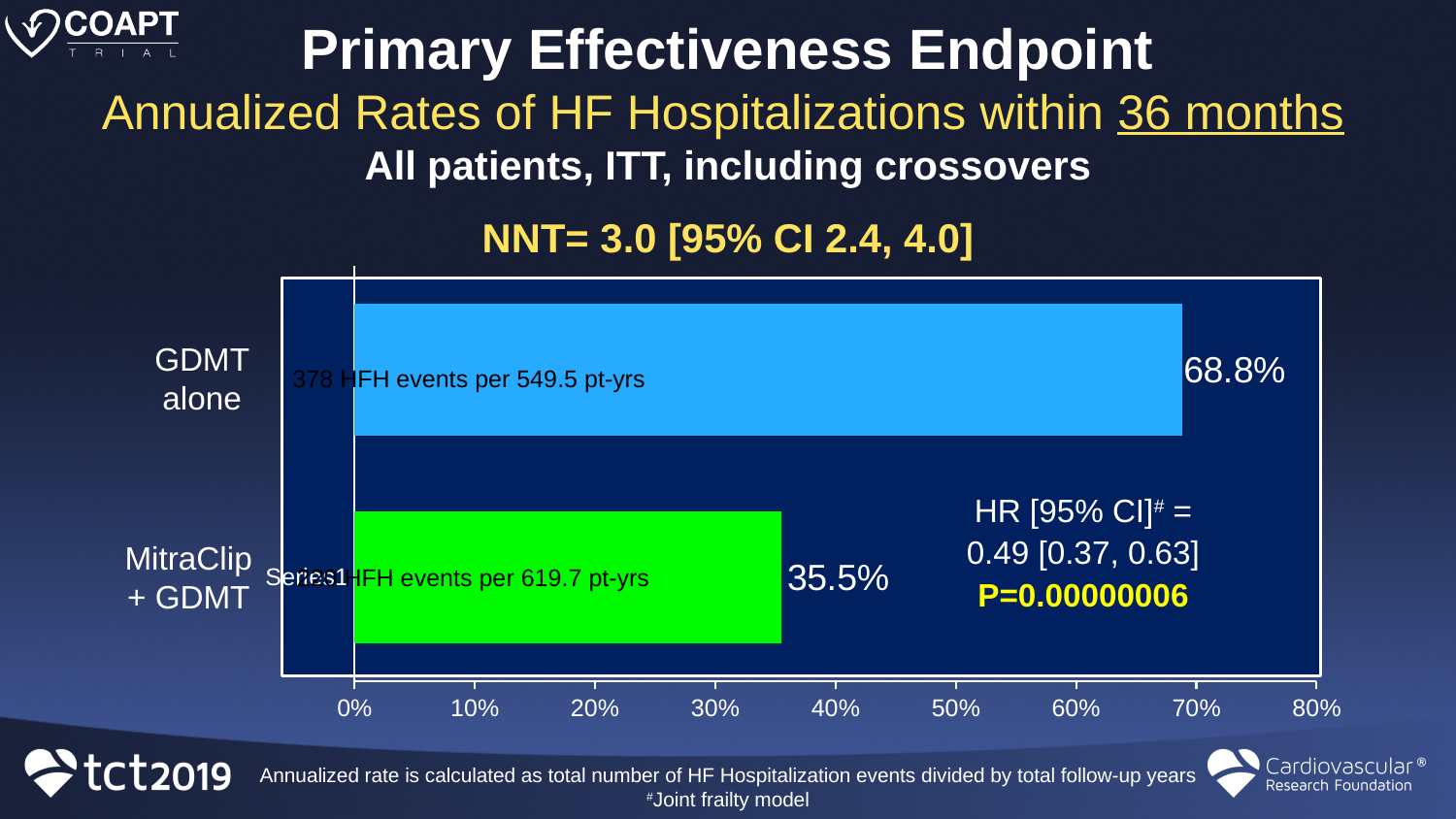
What colour is the bar for MitraClip + GDMT? Green Is the rate for MitraClip + GDMT greater or less than 40%? less Which group has the higher annualized HF hospitalization rate? GDMT alone What is the maximum value shown on the x axis? 80% What is the annualized HF hospitalization rate for MitraClip + GDMT? 35.5% How many groups are plotted in the chart? 2 How many HFH events per how many patient-years are reported for the GDMT alone bar? 378 HFH events per 549.5 pt-yrs Is the rate for GDMT alone greater or less than 60%? greater What is the annualized HF hospitalization rate for GDMT alone? 68.8% What type of chart is shown on the slide? Bar chart What is the difference in percentage points between the GDMT alone rate and the MitraClip + GDMT rate? 33.3 percentage points Which group has the lower annualized HF hospitalization rate? MitraClip + GDMT